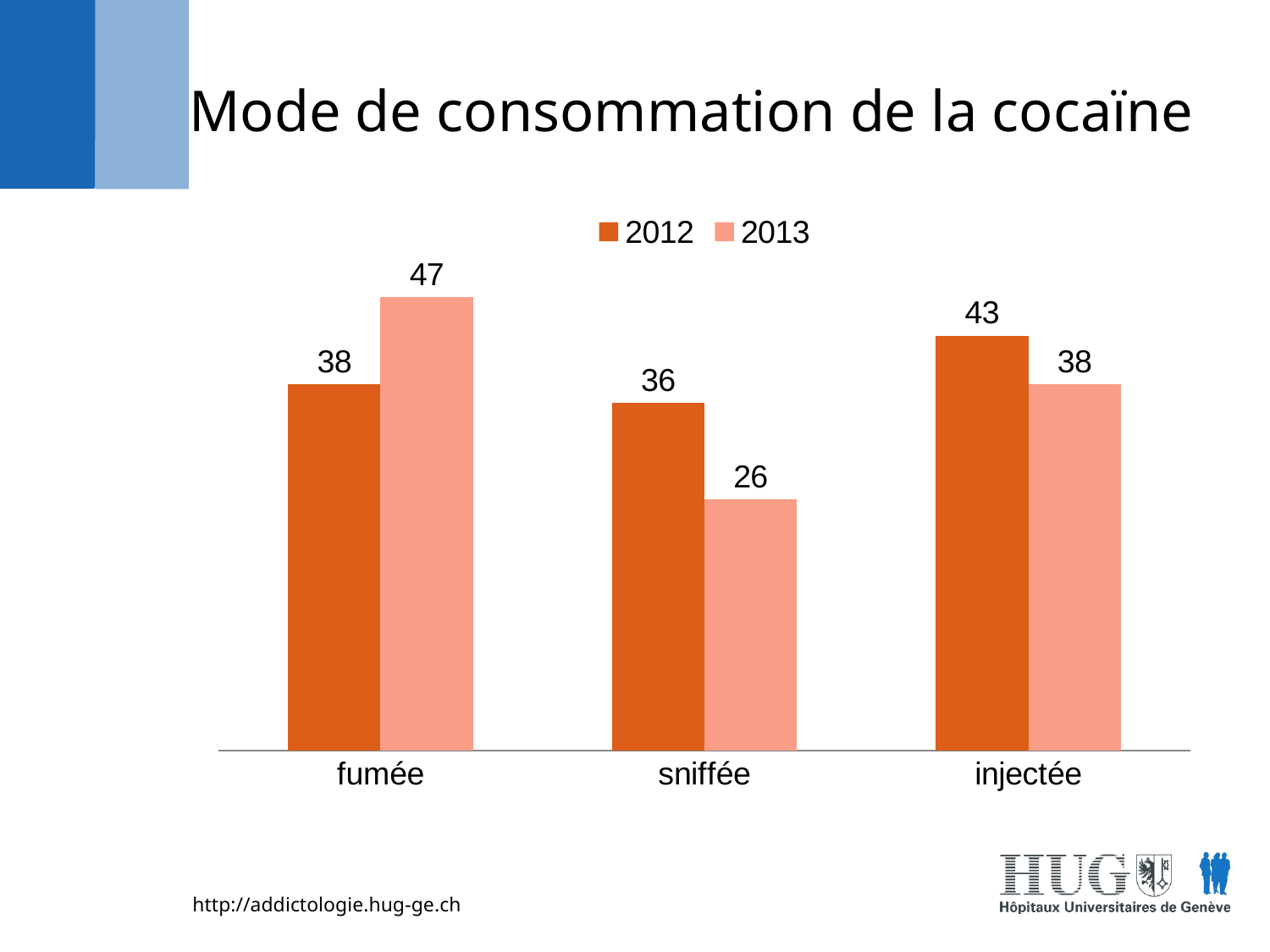
Which category has the lowest value in 2012? sniffée What is the difference between the 2012 and 2013 values for sniffée? 10 What is the value for sniffée in 2013? 26 Which category has the lowest value in 2013? sniffée What is the value for injectée in 2012? 43 What is the value for fumée in 2012? 38 What is the difference between the 2013 and 2012 values for fumée? 9 How many categories are shown on the x axis? 3 Which category has the highest value in 2013? fumée How many series does the legend list? 2 For injectée, which year has the larger value, 2012 or 2013? 2012 What kind of chart is shown on the slide? bar chart